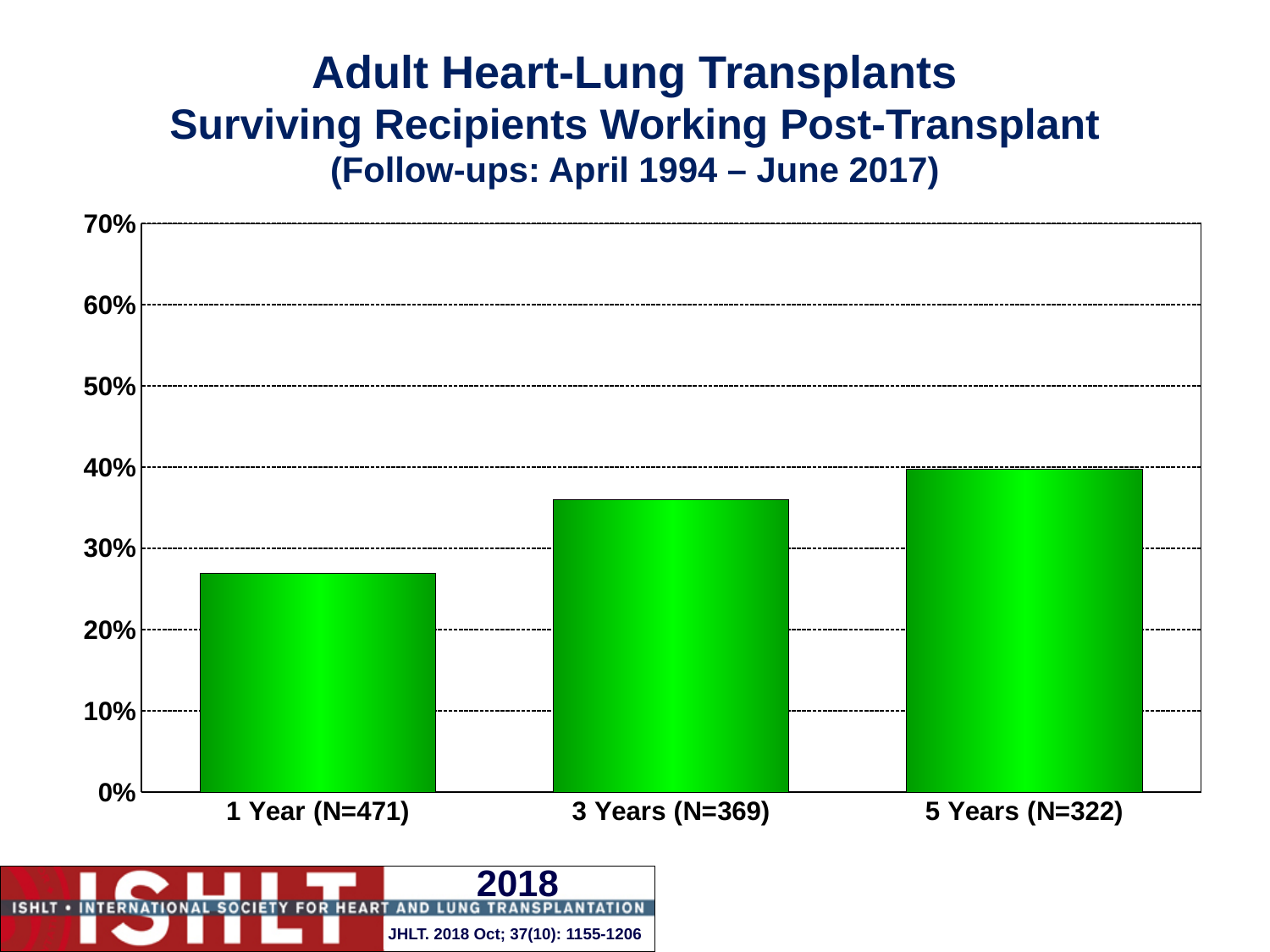
Is the value for 3 Years (N=369) greater or less than 40%? less What follow-up period is given in the chart title? April 1994 – June 2017 How many categories are plotted on the x axis? 3 Which is larger, the value for 3 Years (N=369) or the value for 1 Year (N=471)? 3 Years (N=369) Is the value for 5 Years (N=322) greater or less than 30%? greater What kind of chart is shown on the slide? bar chart Is the value for 3 Years (N=369) greater or less than 30%? greater Do the values rise or fall from 1 Year to 5 Years along the x axis? rise Which category has the highest percentage of surviving recipients working post-transplant? 5 Years (N=322) Which category has the lowest percentage of surviving recipients working post-transplant? 1 Year (N=471)